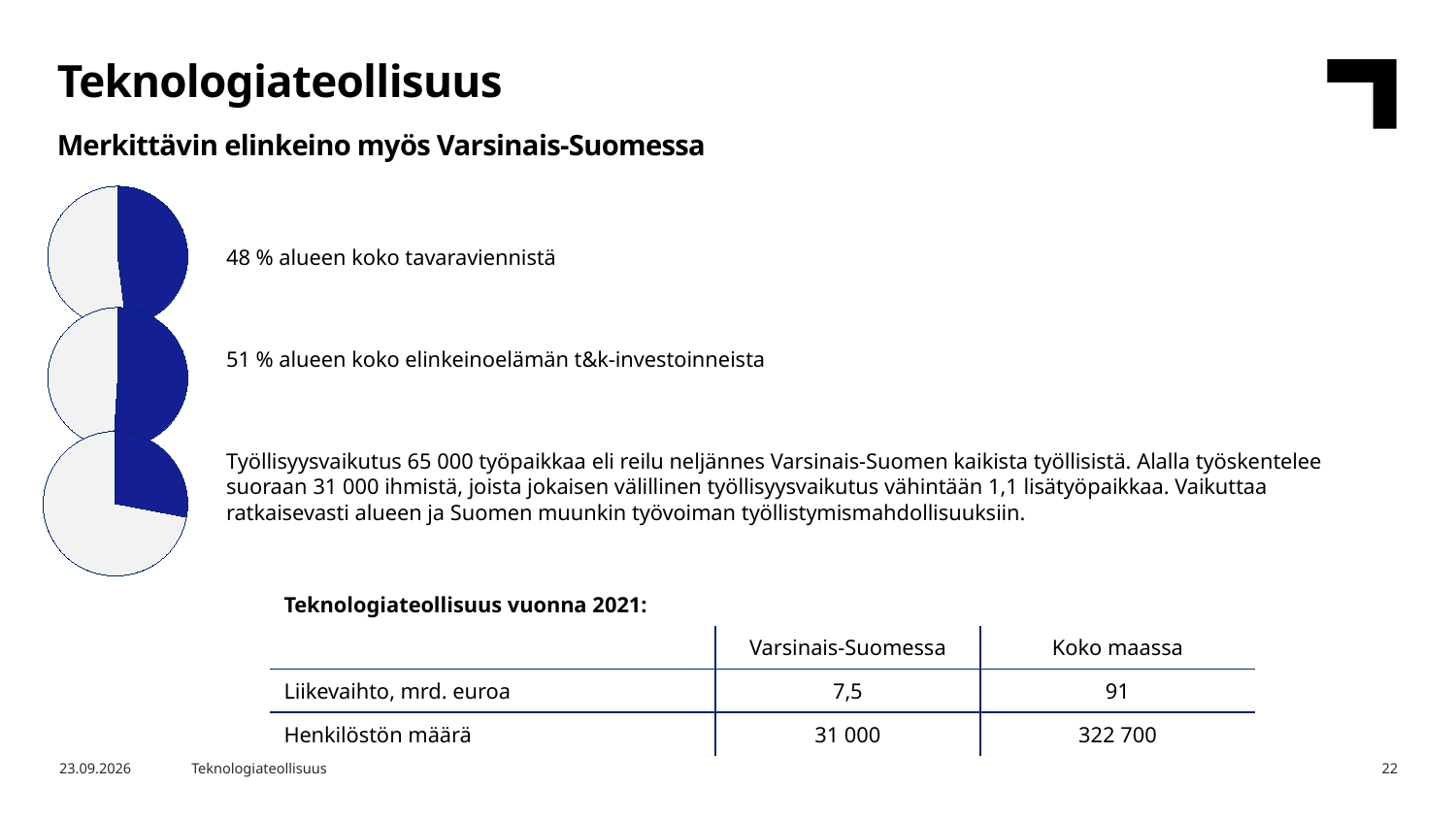
In the bottom pie chart, is the blue slice greater or less than half of the pie? less Which pie chart has the smallest blue slice: the top, middle or bottom one? bottom How many pie charts are on the slide? 3 What two colours are used for the slices in the pie charts? Blue and light grey Is the blue slice larger in the top pie chart or in the bottom pie chart? top According to the text next to the middle pie chart, what share of the region's business R&D investments does the technology industry account for? 51 % What is the text label next to the top pie chart? 48 % alueen koko tavaraviennistä What kind of charts are shown on the left side of the slide? Pie charts According to the text next to the top pie chart, what share of the region's total goods exports does the technology industry account for? 48 %